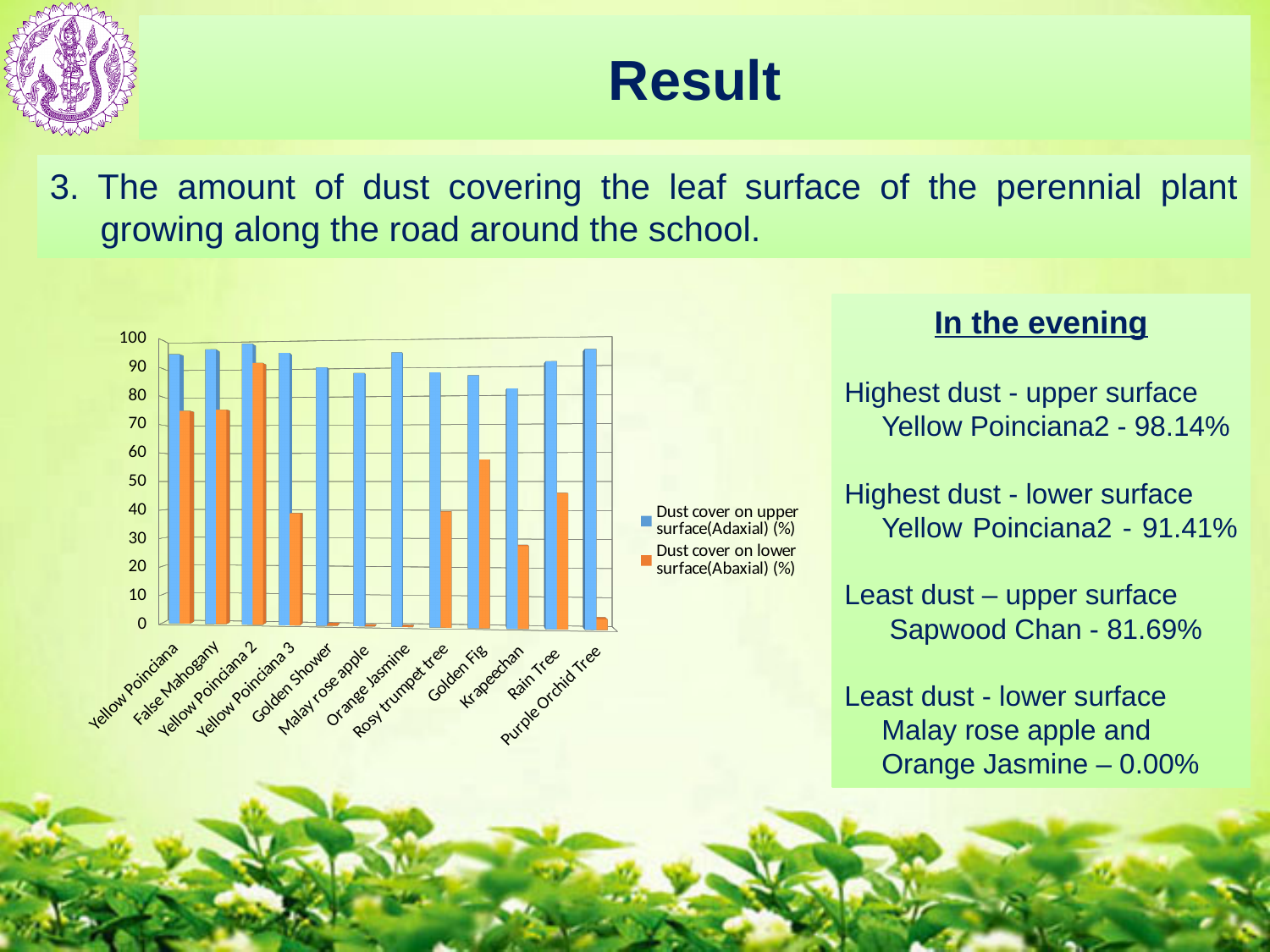
Is the dust cover on the lower surface (Abaxial) for Golden Shower greater or less than 10? less What are the two series named in the chart's legend? Dust cover on upper surface(Adaxial) (%) and Dust cover on lower surface(Abaxial) (%) Is the dust cover on the lower surface (Abaxial) for Golden Fig greater or less than 50? greater Which plant has the highest value for dust cover on the upper surface (Adaxial)? Yellow Poinciana 2 Is the dust cover on the upper surface (Adaxial) for Krapeechan greater or less than 90? less What kind of chart is shown on the slide? bar chart How many series does the chart's legend list? 2 Which has a larger dust cover on the lower surface (Abaxial): Yellow Poinciana or Golden Fig? Yellow Poinciana How many plant categories are shown on the x axis of the chart? 12 Which plant has the lowest value for dust cover on the upper surface (Adaxial)? Krapeechan Which plant has the highest value for dust cover on the lower surface (Abaxial)? Yellow Poinciana 2